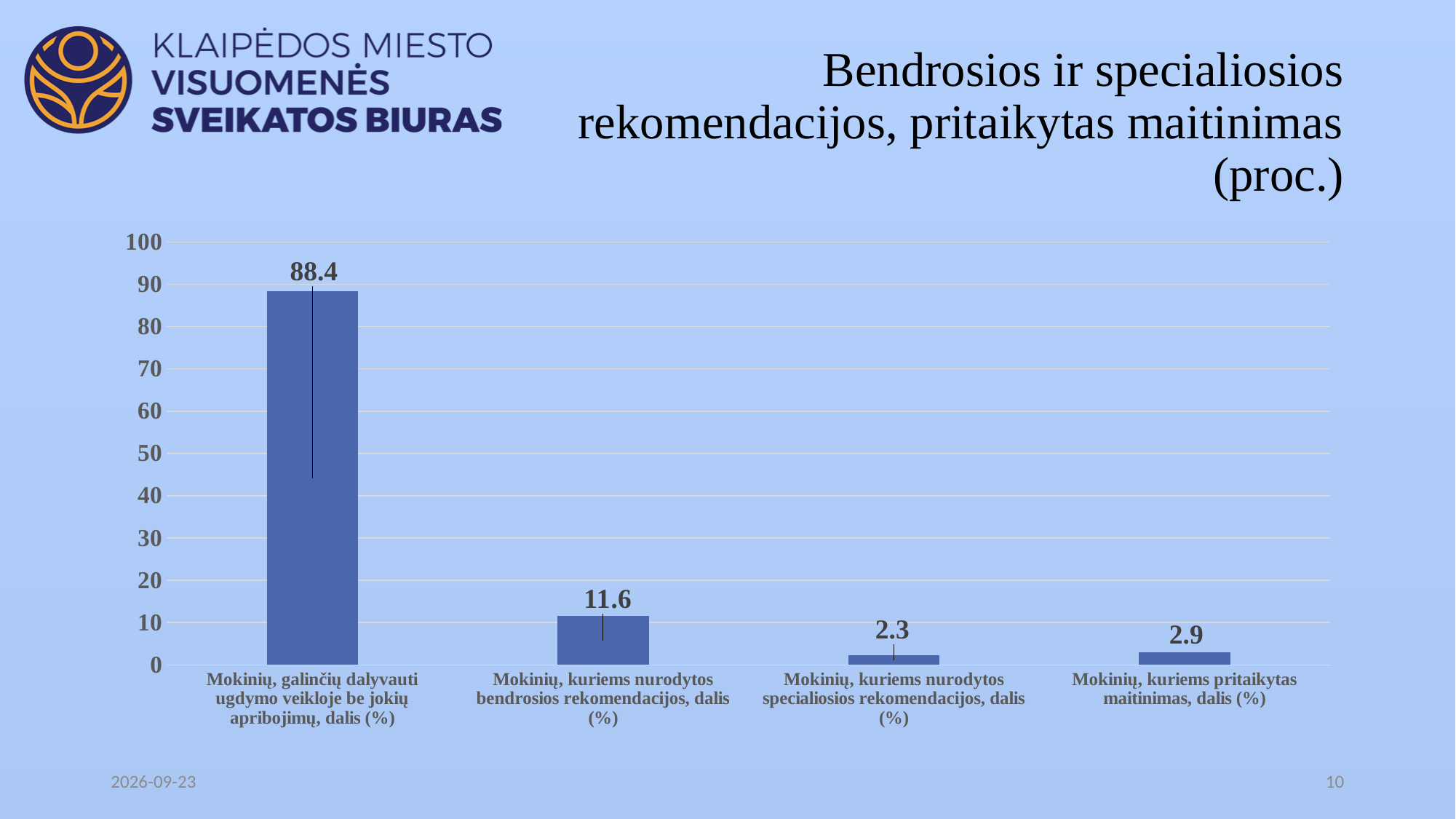
Which category has the lowest value? Mokinių, kuriems nurodytos specialiosios rekomendacijos, dalis (%) What is the value for 'Mokinių, galinčių dalyvauti ugdymo veikloje be jokių apribojimų, dalis (%)'? 88.4 Is the value for 'Mokinių, kuriems nurodytos bendrosios rekomendacijos' greater or less than 20? less Which is larger: the value for 'Mokinių, kuriems pritaikytas maitinimas' or 'Mokinių, kuriems nurodytos specialiosios rekomendacijos'? Mokinių, kuriems pritaikytas maitinimas, dalis (%) What is the value for 'Mokinių, kuriems pritaikytas maitinimas, dalis (%)'? 2.9 What is the value for 'Mokinių, kuriems nurodytos bendrosios rekomendacijos, dalis (%)'? 11.6 How many categories are shown in the chart? 4 What is the value for 'Mokinių, kuriems nurodytos specialiosios rekomendacijos, dalis (%)'? 2.3 What is the difference between the values for 'Mokinių, kuriems pritaikytas maitinimas' and 'Mokinių, kuriems nurodytos specialiosios rekomendacijos'? 0.6 What is the difference between the values for 'Mokinių, galinčių dalyvauti ugdymo veikloje be jokių apribojimų' and 'Mokinių, kuriems nurodytos bendrosios rekomendacijos'? 76.8 Which category has the highest value? Mokinių, galinčių dalyvauti ugdymo veikloje be jokių apribojimų, dalis (%) What kind of chart is shown on the slide? bar chart